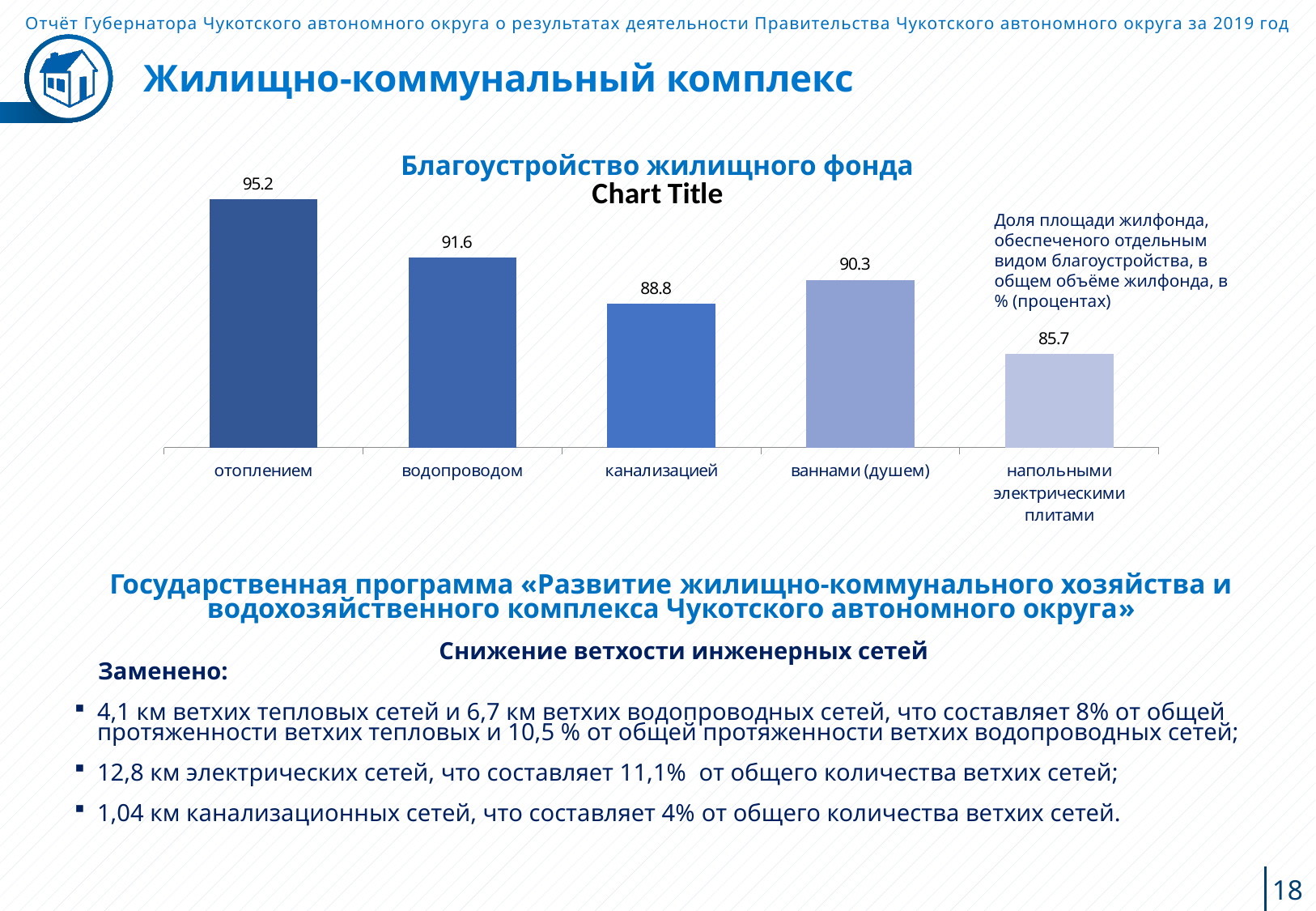
Какое значение показано для категории «канализацией»? 88.8 Какая категория имеет наибольшее значение на диаграмме? отоплением На сколько значение для «водопроводом» больше значения для «канализацией»? 2.8 Какое значение показано для категории «отоплением»? 95.2 Какое значение показано для категории «ваннами (душем)»? 90.3 Какая категория имеет наименьшее значение на диаграмме? напольными электрическими плитами Что больше: значение для «канализацией» или для «ваннами (душем)»? ваннами (душем) На сколько значение для «отоплением» больше значения для «напольными электрическими плитами»? 9.5 Какое значение показано для категории «водопроводом»? 91.6 Сколько категорий показано на диаграмме? 5 Какое значение показано для категории «напольными электрическими плитами»? 85.7 Какого типа эта диаграмма? столбчатая (bar chart)